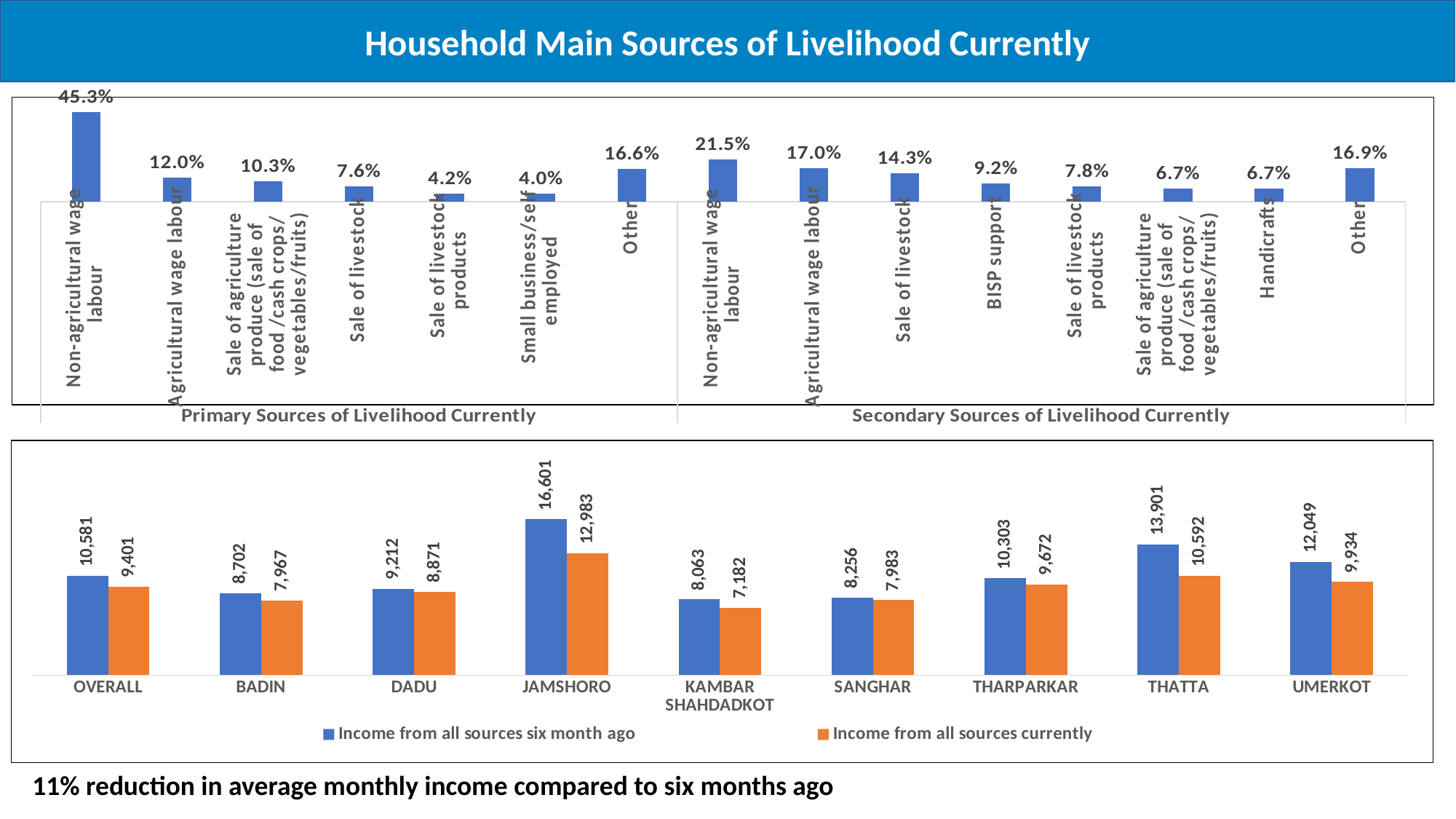
In the top chart, what is the value for BISP support under Secondary Sources of Livelihood Currently? 9.2% In the bottom chart, what is the difference between OVERALL income six month ago and OVERALL income currently? 1,180 How many series does the legend of the bottom chart list? 2 In the top chart, what is the difference between Agricultural wage labour under Primary Sources (12.0%) and Agricultural wage labour under Secondary Sources (17.0%)? 5.0% In the bottom chart, which district has the lowest income from all sources currently? KAMBAR SHAHDADKOT In the bottom chart, what is the income from all sources six month ago for THATTA? 13,901 What type of chart is the bottom chart? Bar chart In the bottom chart, what is the income from all sources currently for JAMSHORO? 12,983 In the top chart, what is the value for Non-agricultural wage labour under Primary Sources of Livelihood Currently? 45.3% In the bottom chart, which district has the highest income from all sources six month ago? JAMSHORO In the top chart, which category has the highest value under Secondary Sources of Livelihood Currently? Non-agricultural wage labour In the top chart, which category has the lowest value under Primary Sources of Livelihood Currently? Small business/self employed